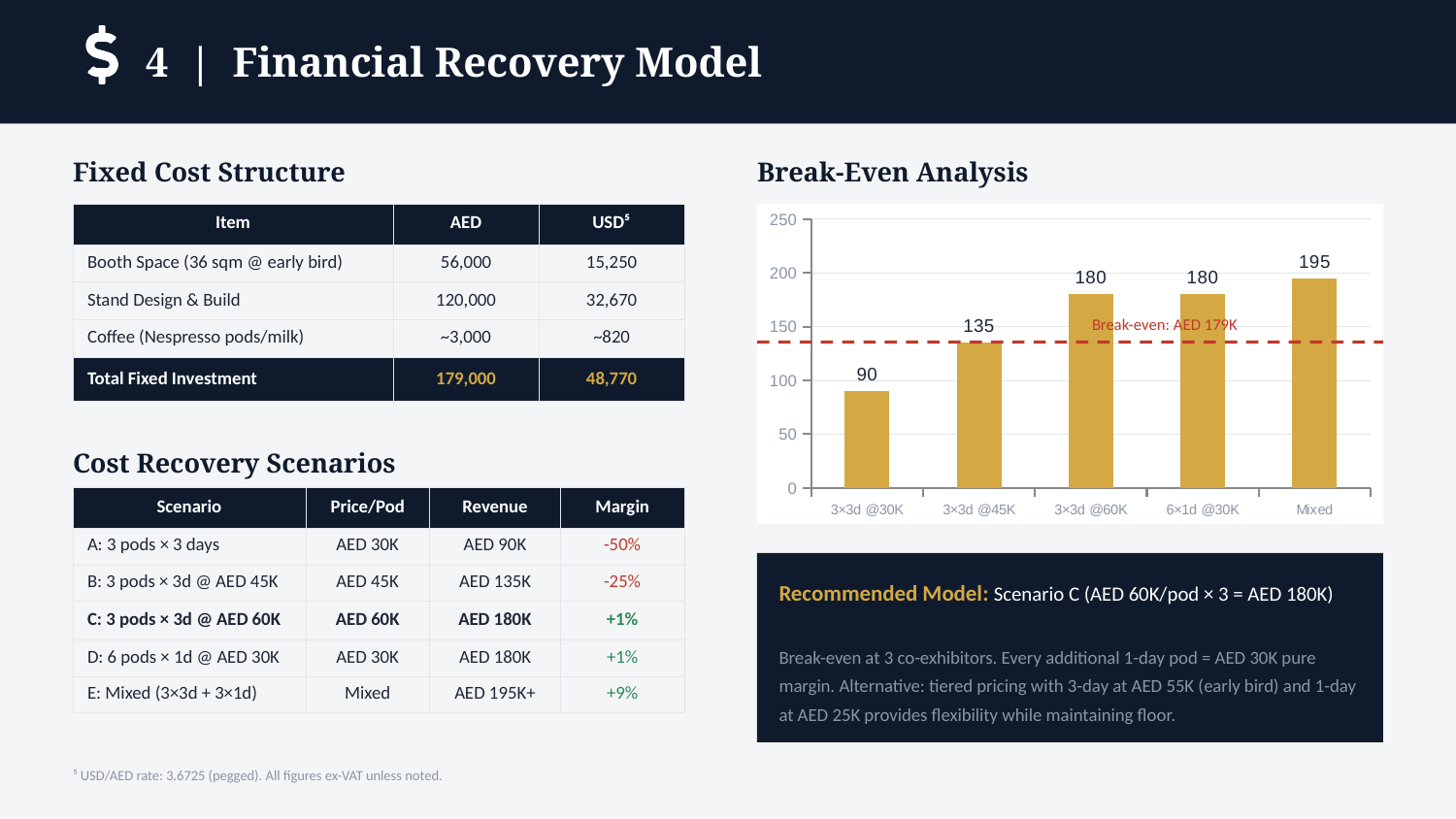
In the Break-Even Analysis chart, what is the difference between the values for 3×3d @60K and 3×3d @30K? 90 How many bars are plotted in the Break-Even Analysis chart? 5 What type of chart is shown in the Break-Even Analysis? bar chart In the Break-Even Analysis chart, what does the dashed red line represent? Break-even: AED 179K In the Break-Even Analysis chart, which category has the lowest value? 3×3d @30K In the Break-Even Analysis chart, what is the difference between the values for Mixed and 3×3d @45K? 60 In the Break-Even Analysis chart, what is the value for Mixed? 195 In the Break-Even Analysis chart, what is the value for 3×3d @45K? 135 In the Break-Even Analysis chart, which is larger: the value for 3×3d @45K or the value for 6×1d @30K? 6×1d @30K In the Break-Even Analysis chart, what is the value for 3×3d @30K? 90 In the Break-Even Analysis chart, which category has the highest value? Mixed In the Break-Even Analysis chart, is the value for 3×3d @45K greater or less than 150? less